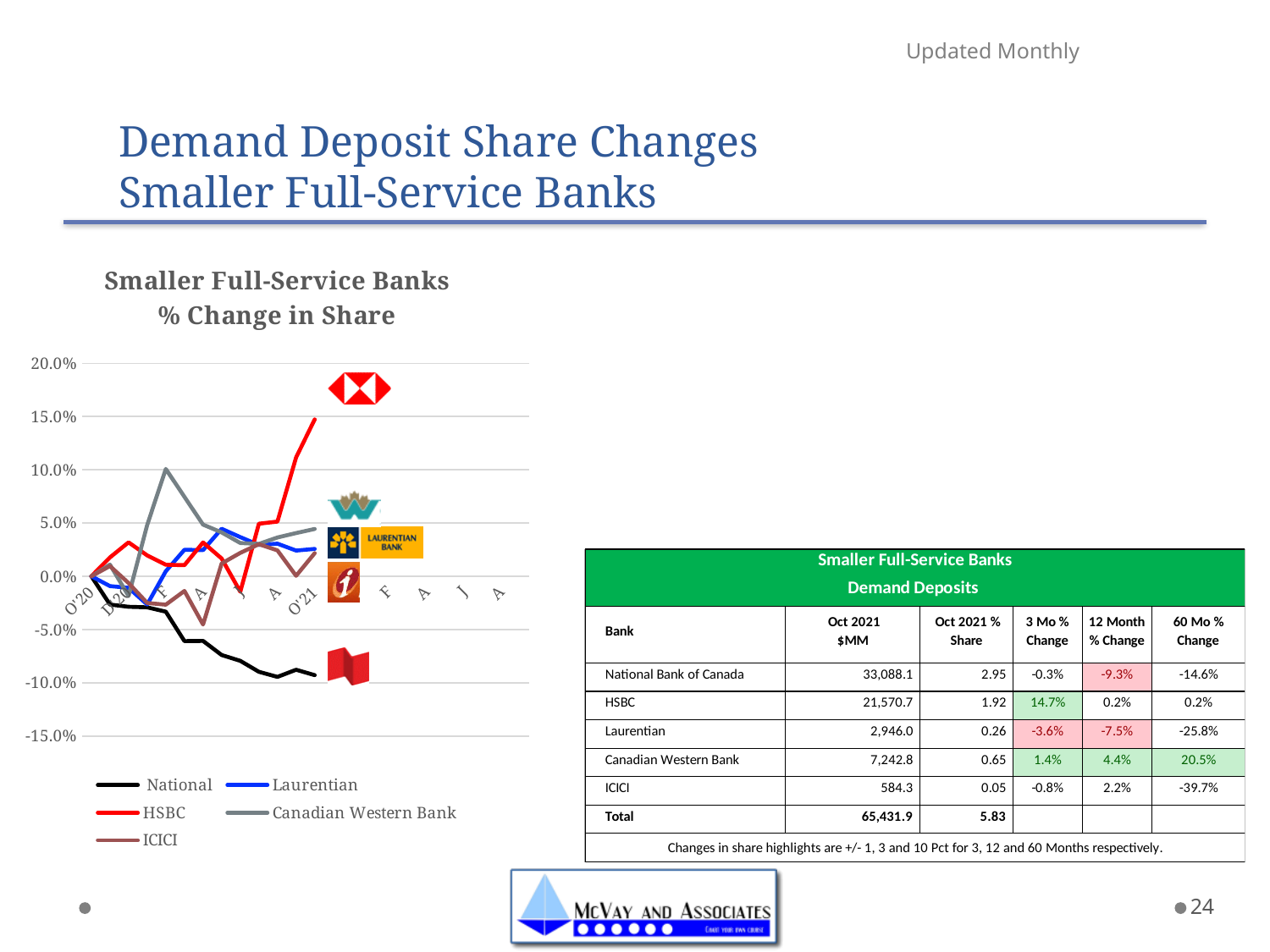
Is the highest value reached by the Canadian Western Bank line greater or less than 5.0%? greater What is the title of the chart? Smaller Full-Service Banks % Change in Share Which bank has the highest % change in share at the end of the chart (O'21)? HSBC What kind of chart is shown on the slide? line chart At O'21, which is larger: the value for HSBC or the value for National? HSBC Is the value for HSBC at O'21 greater or less than 10.0%? greater Does the HSBC line rise or fall overall from O'20 to O'21? rise How many series does the chart legend list? 5 Which bank has the lowest % change in share at the end of the chart (O'21)? National Is the value for National at O'21 greater or less than -5.0%? less Does the National line rise or fall from O'20 to O'21? fall What colour is the HSBC line in the chart? red